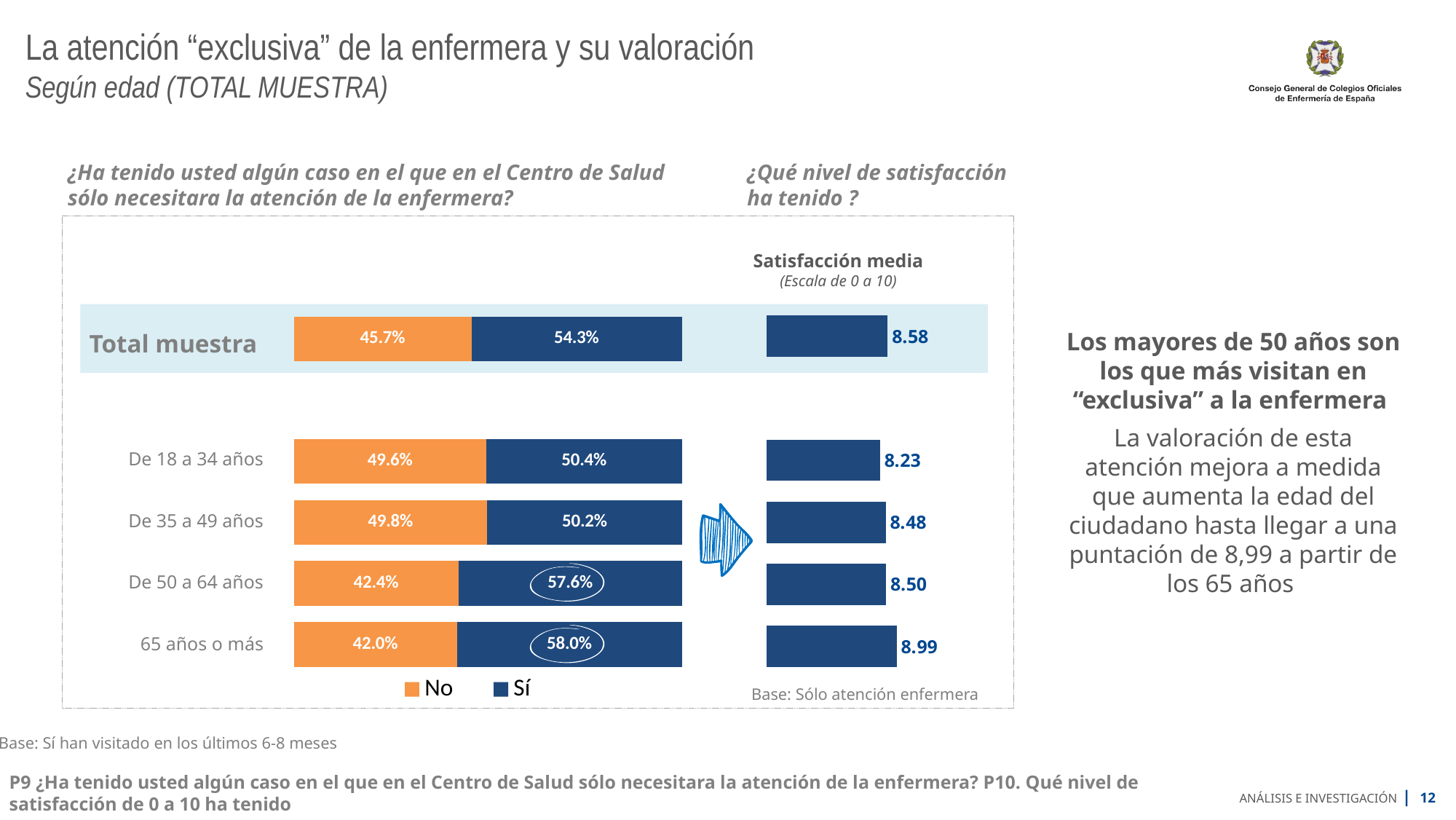
In the stacked bar chart on the left, what percentage of the 'Total muestra' answered 'No'? 45.7% In the stacked bar chart on the left, what percentage of the 'De 50 a 64 años' group answered 'Sí'? 57.6% How many series does the legend of the stacked bar chart on the left list? 2 In the 'Satisfacción media' chart, what is the mean satisfaction for 'De 18 a 34 años'? 8.23 In the stacked bar chart on the left, which age group has the highest 'Sí' percentage? 65 años o más In the 'Satisfacción media' chart, what is the mean satisfaction for '65 años o más'? 8.99 In the stacked bar chart on the left, what is the difference between the 'Sí' percentage for 'De 50 a 64 años' and 'De 18 a 34 años'? 7.2 percentage points In the 'Satisfacción media' chart, which age group has the highest mean satisfaction? 65 años o más In the 'Satisfacción media' chart, what is the difference between the mean satisfaction of '65 años o más' and 'De 18 a 34 años'? 0.76 In the 'Satisfacción media' chart, which age group has the lowest mean satisfaction? De 18 a 34 años In the stacked bar chart on the left, is the 'No' percentage larger for 'De 35 a 49 años' or for '65 años o más'? De 35 a 49 años What type of chart is used to show the 'Satisfacción media' values? Bar chart